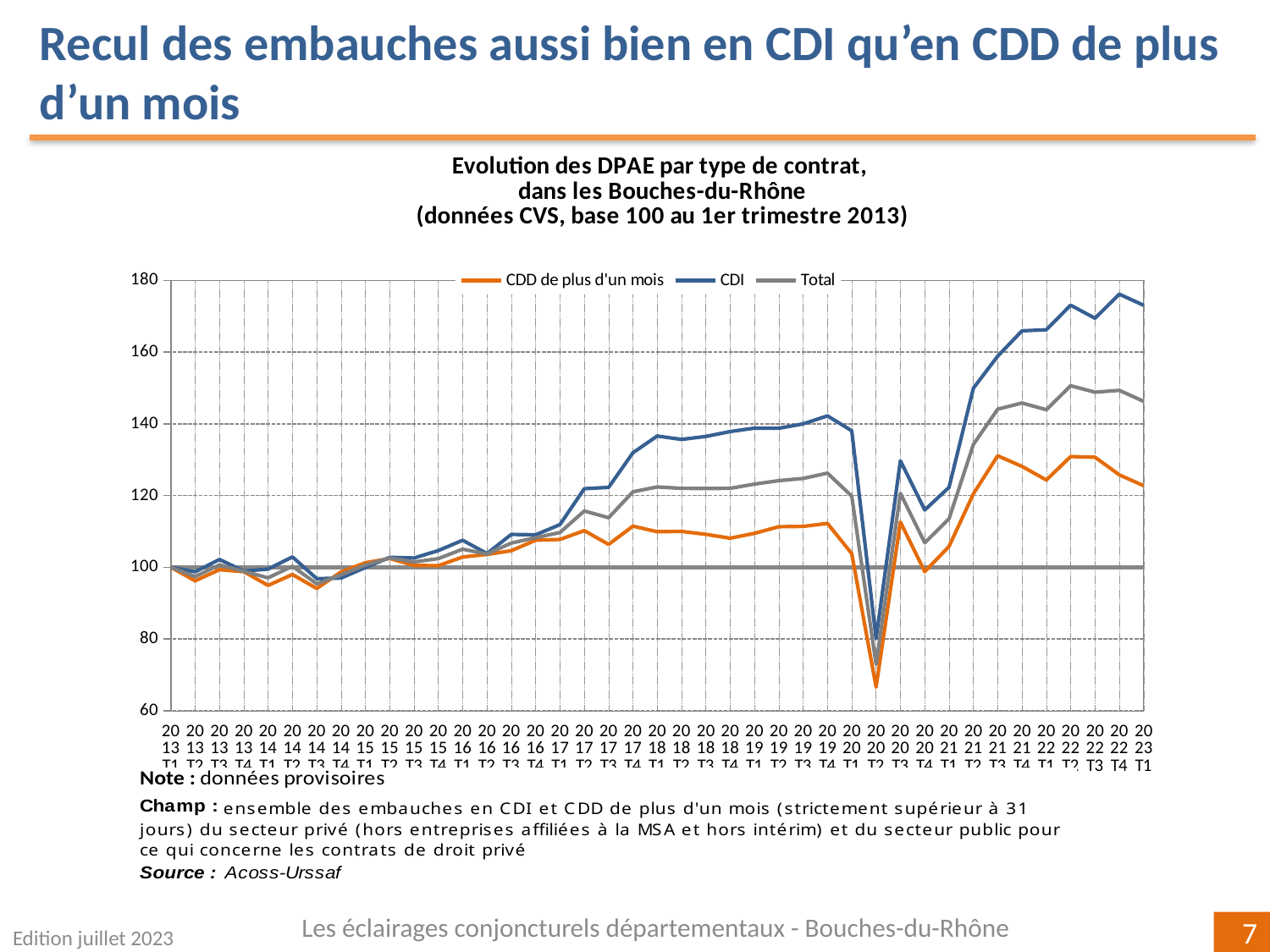
Which series are listed in the legend? CDD de plus d'un mois, CDI, Total What is the base period of the index used in the chart? 1er trimestre 2013 (base 100) Is the value for Total in 2023 T1 greater or less than 140? greater In 2023 T1, which series has the higher value, CDI or CDD de plus d'un mois? CDI How many series does the legend list? 3 In which quarter does the CDI series reach its lowest value? 2020 T2 Is the value for CDD de plus d'un mois in 2020 T2 greater or less than 80? less In which quarter does the CDI series reach its highest value? 2022 T4 What kind of chart is shown on the slide? line chart Does the CDI series rise or fall between 2022 T4 and 2023 T1? fall Is the value for CDI in 2023 T1 greater or less than 160? greater